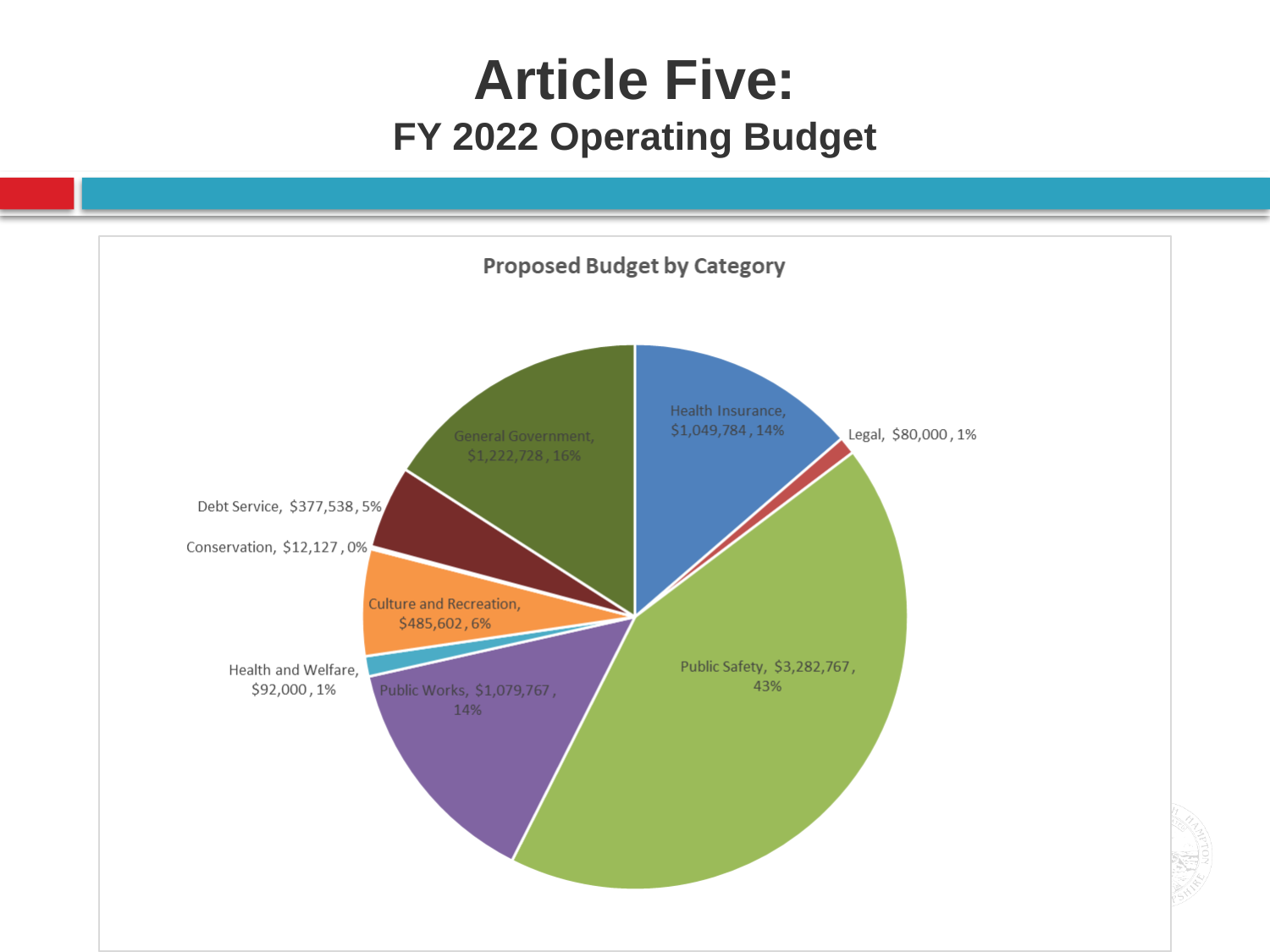
Which has a larger budget amount, Debt Service or Culture and Recreation? Culture and Recreation What is the proposed budget amount for General Government? $1,222,728 What is the proposed budget amount for Conservation? $12,127 What type of chart is shown on the slide? Pie chart What is the difference between the Public Safety and General Government budget amounts? $2,060,039 What percentage of the proposed budget goes to Culture and Recreation? 6% What is the proposed budget amount for Public Safety? $3,282,767 Which category has the smallest share of the proposed budget? Conservation How many categories are shown in the pie chart? 9 Which category has the largest share of the proposed budget? Public Safety What is the title of the chart? Proposed Budget by Category What percentage of the proposed budget goes to Public Safety? 43%